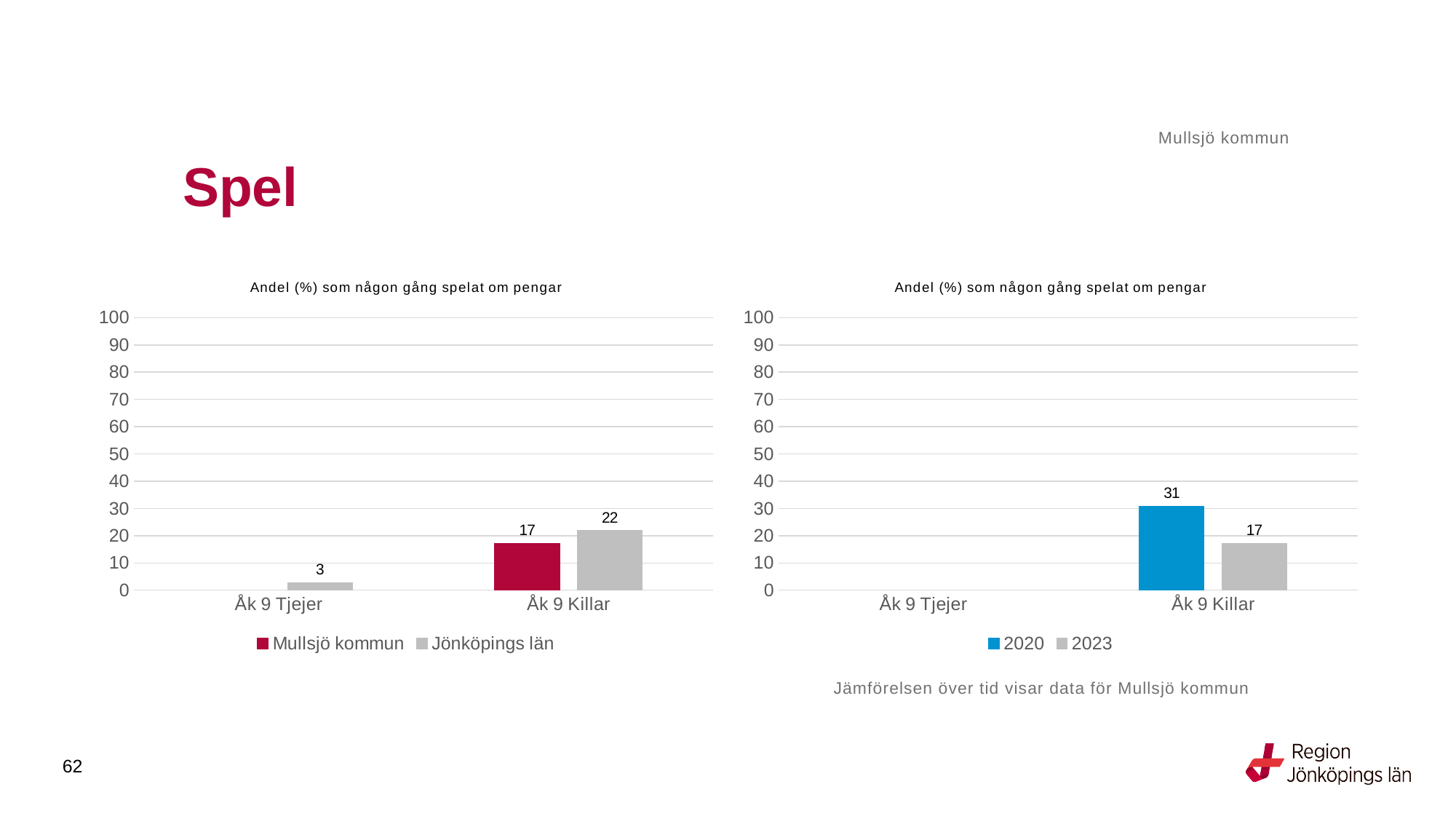
In the left chart, which is larger for Åk 9 Killar: Mullsjö kommun or Jönköpings län? Jönköpings län In the right chart, what is the value for 2023 for Åk 9 Killar? 17 In the left chart, what is the value for Jönköpings län for Åk 9 Tjejer? 3 In the right chart, what is the value for 2020 for Åk 9 Killar? 31 In the left chart, what is the difference between Jönköpings län and Mullsjö kommun for Åk 9 Killar? 5 What is the title of the left chart? Andel (%) som någon gång spelat om pengar In the left chart, what is the value for Jönköpings län for Åk 9 Killar? 22 What kind of chart is the right chart? Bar chart In the left chart, what is the value for Mullsjö kommun for Åk 9 Killar? 17 In the right chart, what is the difference between the 2020 and 2023 values for Åk 9 Killar? 14 In the right chart, which year has the higher value for Åk 9 Killar? 2020 In the left chart, how many series does the legend list? 2